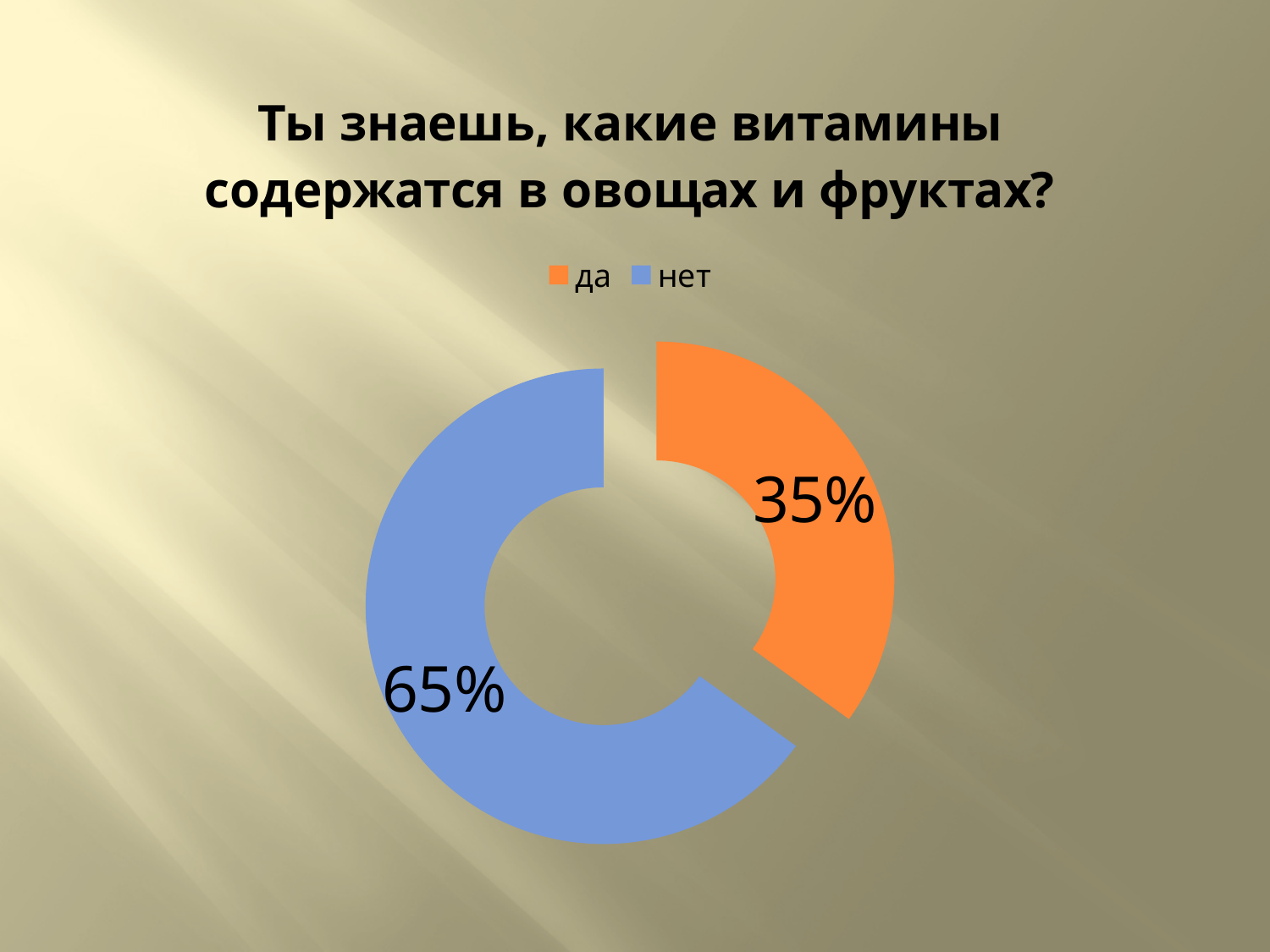
How many categories does the chart show? 2 Which answer has the largest share of the chart? нет What percentage of respondents answered "да"? 35% What percentage of respondents answered "нет"? 65% What is the title of the chart? Ты знаешь, какие витамины содержатся в овощах и фруктах? What share of the chart does the "да" slice take? 35% What kind of chart is shown on the slide? Doughnut (pie) chart How many entries does the legend list? 2 Which is larger, the share for "да" or the share for "нет"? нет What colour is the "нет" slice? Blue Which answer has the smallest share of the chart? да What is the difference in percentage points between "нет" and "да"? 30